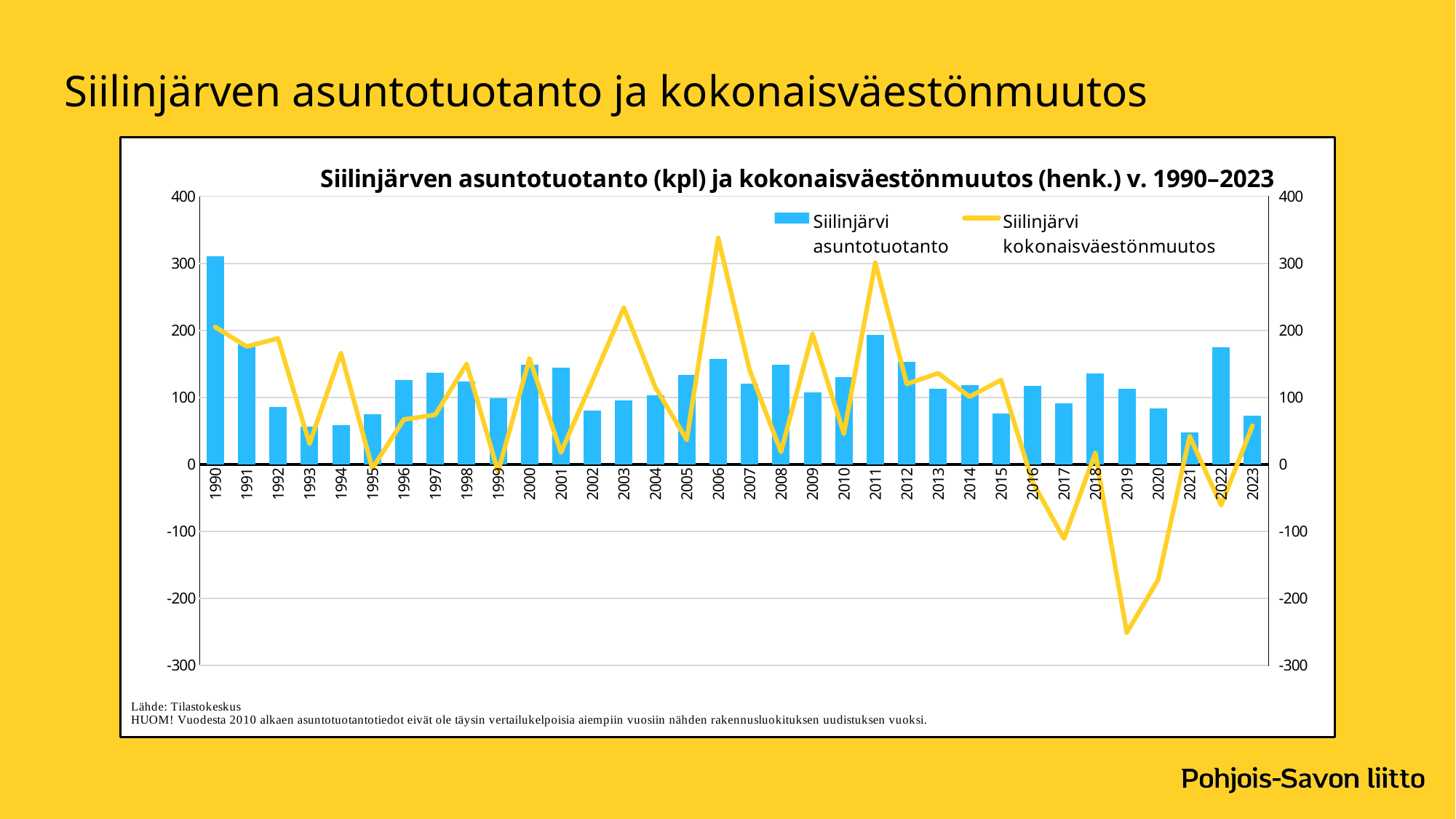
Is the Siilinjärvi kokonaisväestönmuutos value for 2019 greater or less than -200? less Is the Siilinjärvi asuntotuotanto bar for 1990 greater or less than 200? greater In which year does the Siilinjärvi kokonaisväestönmuutos line reach its highest point? 2006 In which year does the Siilinjärvi kokonaisväestönmuutos line reach its lowest point? 2019 Is the Siilinjärvi asuntotuotanto bar for 2021 greater or less than 100? less How many series does the legend list? 2 Which year has the highest bar for Siilinjärvi asuntotuotanto? 1990 What kind of chart is shown on the slide? A combined bar and line chart How many years are shown on the x axis? 34 Does the Siilinjärvi kokonaisväestönmuutos line rise or fall from 2018 to 2019? Fall Which is larger, the Siilinjärvi asuntotuotanto bar for 2022 or for 2023? 2022